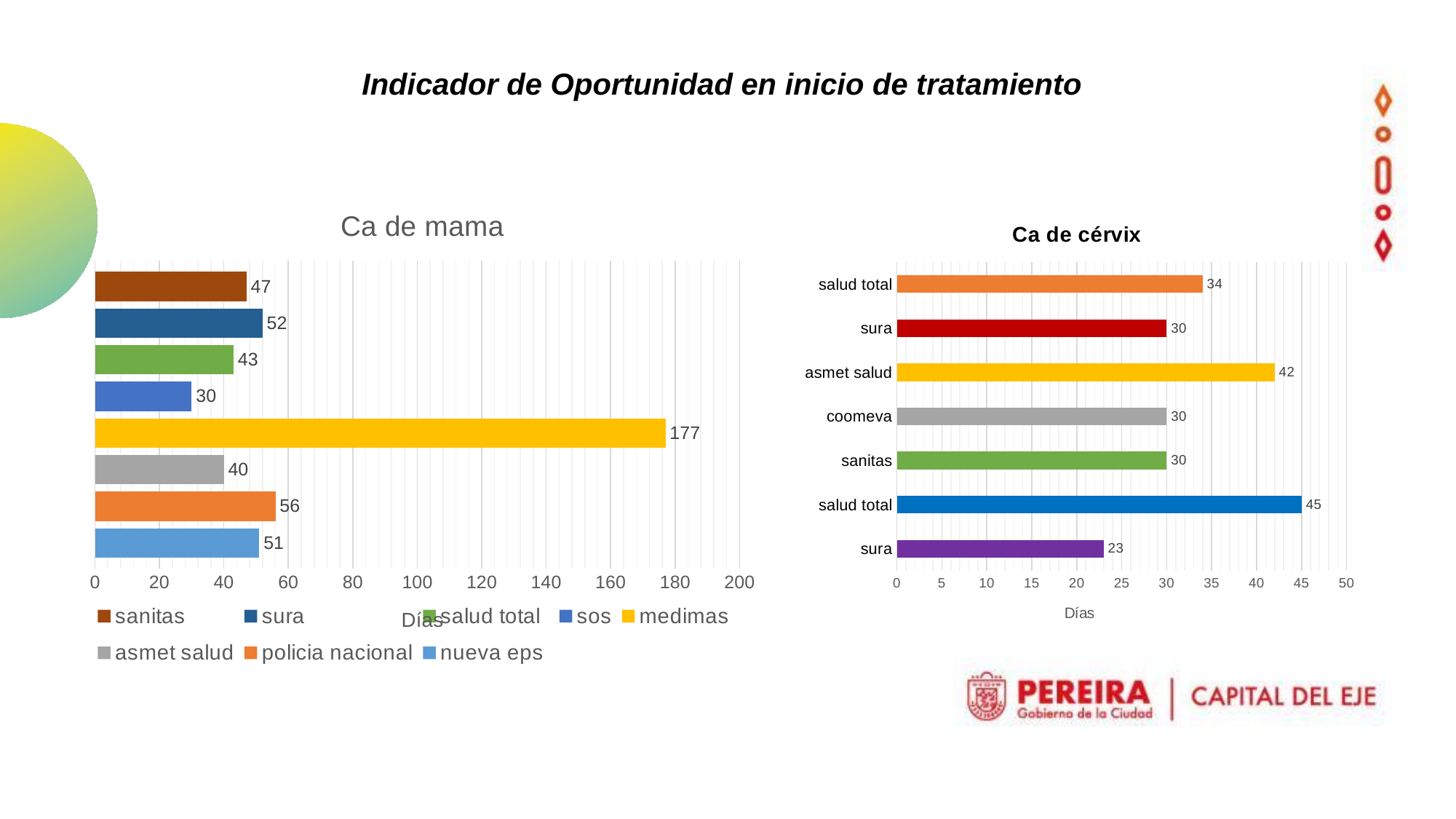
In the 'Ca de mama' chart, what is the value for medimas? 177 What kind of chart is the 'Ca de cérvix' chart? bar chart In the 'Ca de mama' chart, which entity has the highest value? medimas In the 'Ca de mama' chart, what is the value for policia nacional? 56 In the 'Ca de cérvix' chart, what is the value for asmet salud? 42 In the 'Ca de mama' chart, which is larger, the value for nueva eps or the value for asmet salud? nueva eps How many bars are in the 'Ca de cérvix' chart? 7 How many entries does the legend of the 'Ca de mama' chart list? 8 In the 'Ca de cérvix' chart, what is the value for coomeva? 30 In the 'Ca de mama' chart, what is the difference between the values for sura and sanitas? 5 In the 'Ca de mama' chart, which entity has the lowest value? sos In the 'Ca de cérvix' chart, what is the highest value shown? 45